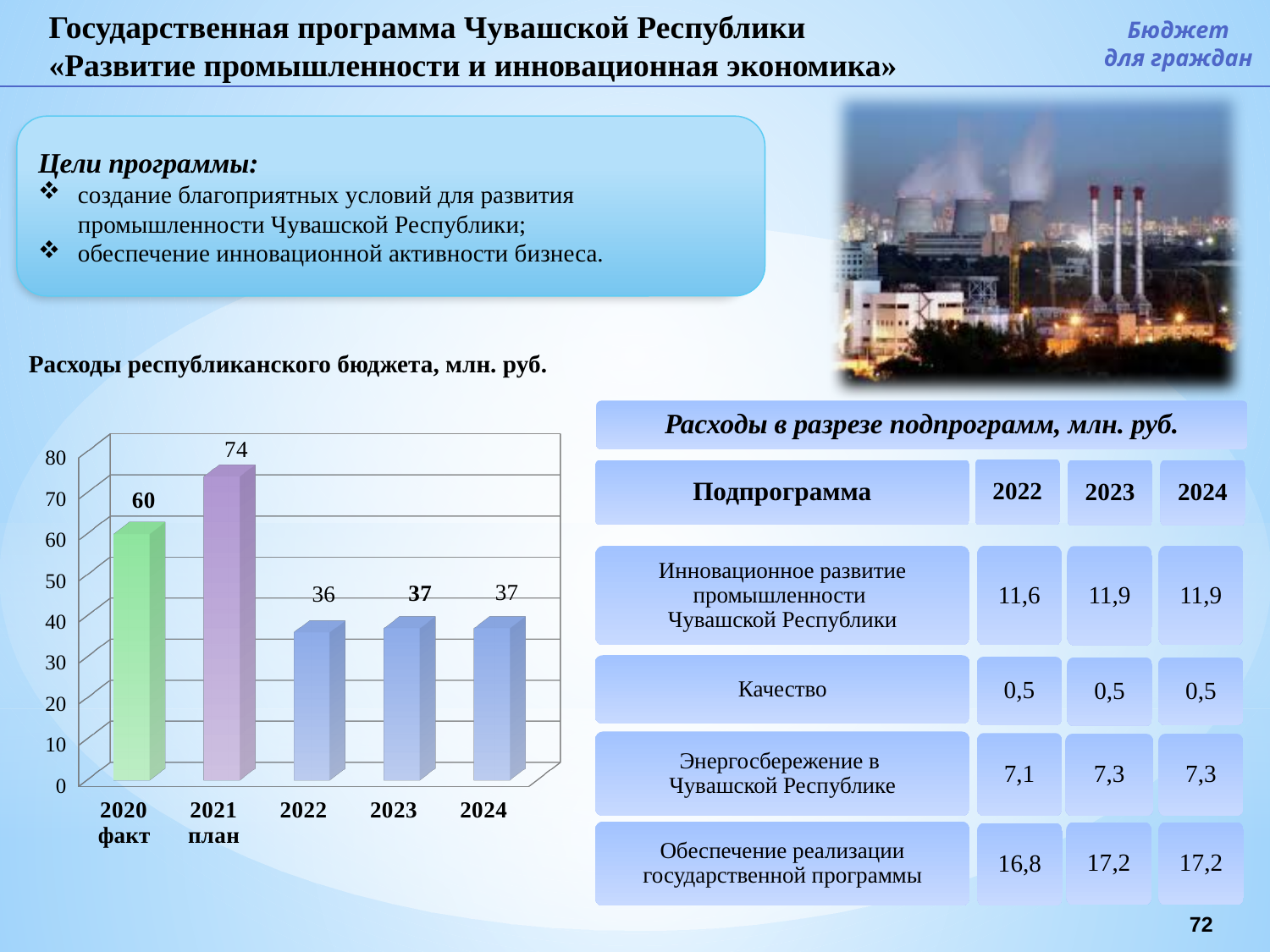
Which is larger, the value for 2020 факт or the value for 2023? 2020 факт What is the title of the chart on the slide? Расходы республиканского бюджета, млн. руб. What is the value for 2020 факт in the chart? 60 What is the difference between the values for 2021 план and 2020 факт? 14 What kind of chart is shown on the slide? bar chart How many years (categories) are shown in the chart? 5 Which year has the lowest value in the chart? 2022 What is the value for 2024 in the chart? 37 What is the value for 2021 план in the chart 'Расходы республиканского бюджета, млн. руб.'? 74 Which year has the highest value in the chart? 2021 план What is the difference between the values for 2020 факт and 2022? 24 What is the value for 2022 in the chart? 36